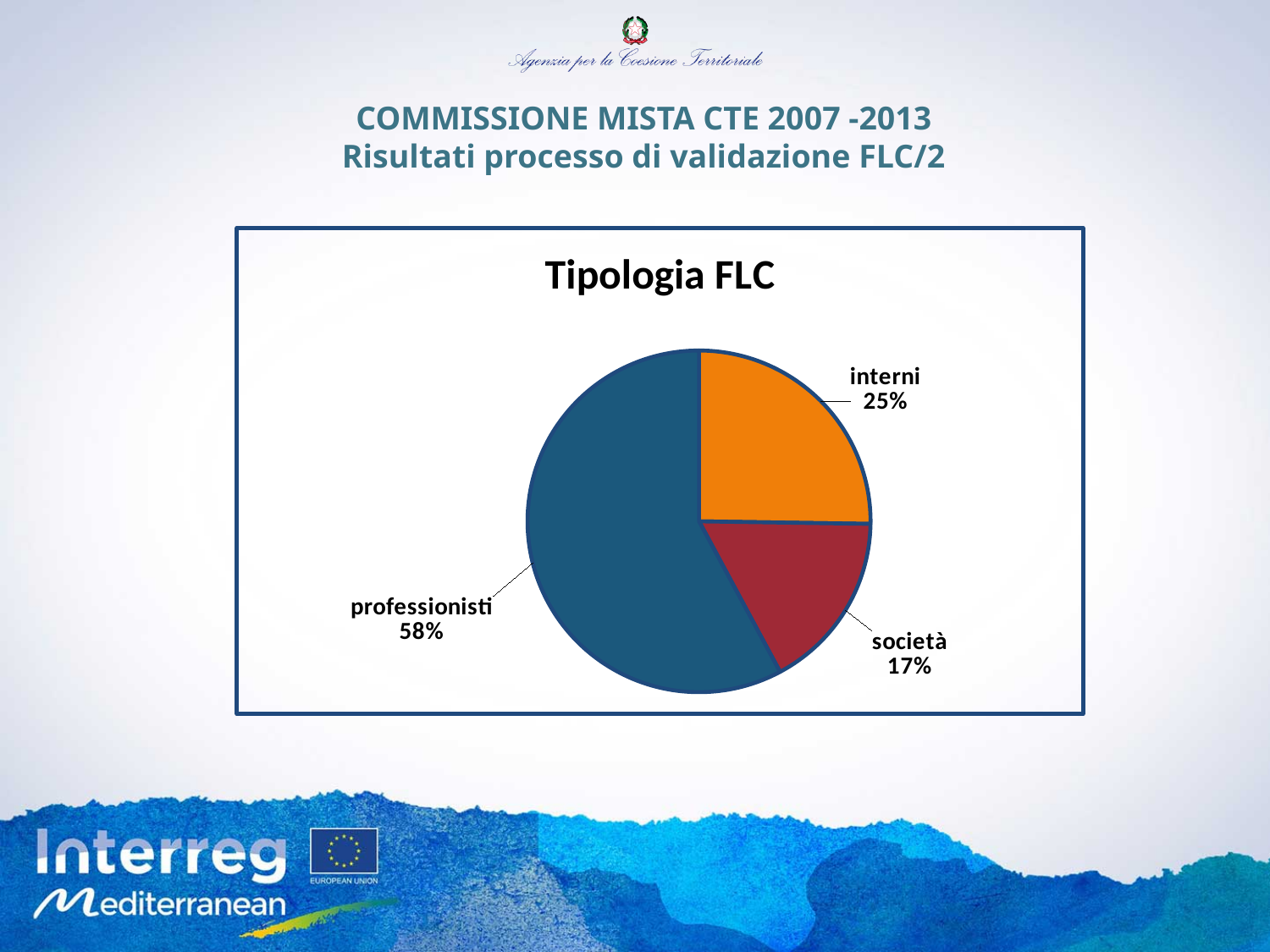
How many slices does the pie chart have? 3 Which category has the largest slice of the pie? professionisti What colour is the 'professionisti' slice? blue What kind of chart is shown on the slide? pie chart Which category has the smallest slice of the pie? società What is the title of the chart? Tipologia FLC Which is larger, the share for 'interni' or the share for 'società'? interni What share of the pie does the 'società' slice represent? 17% What share of the pie does the 'interni' slice represent? 25% What is the difference in percentage points between 'professionisti' and 'interni'? 33 What is the difference in percentage points between 'interni' and 'società'? 8 What share of the pie does the 'professionisti' slice represent? 58%